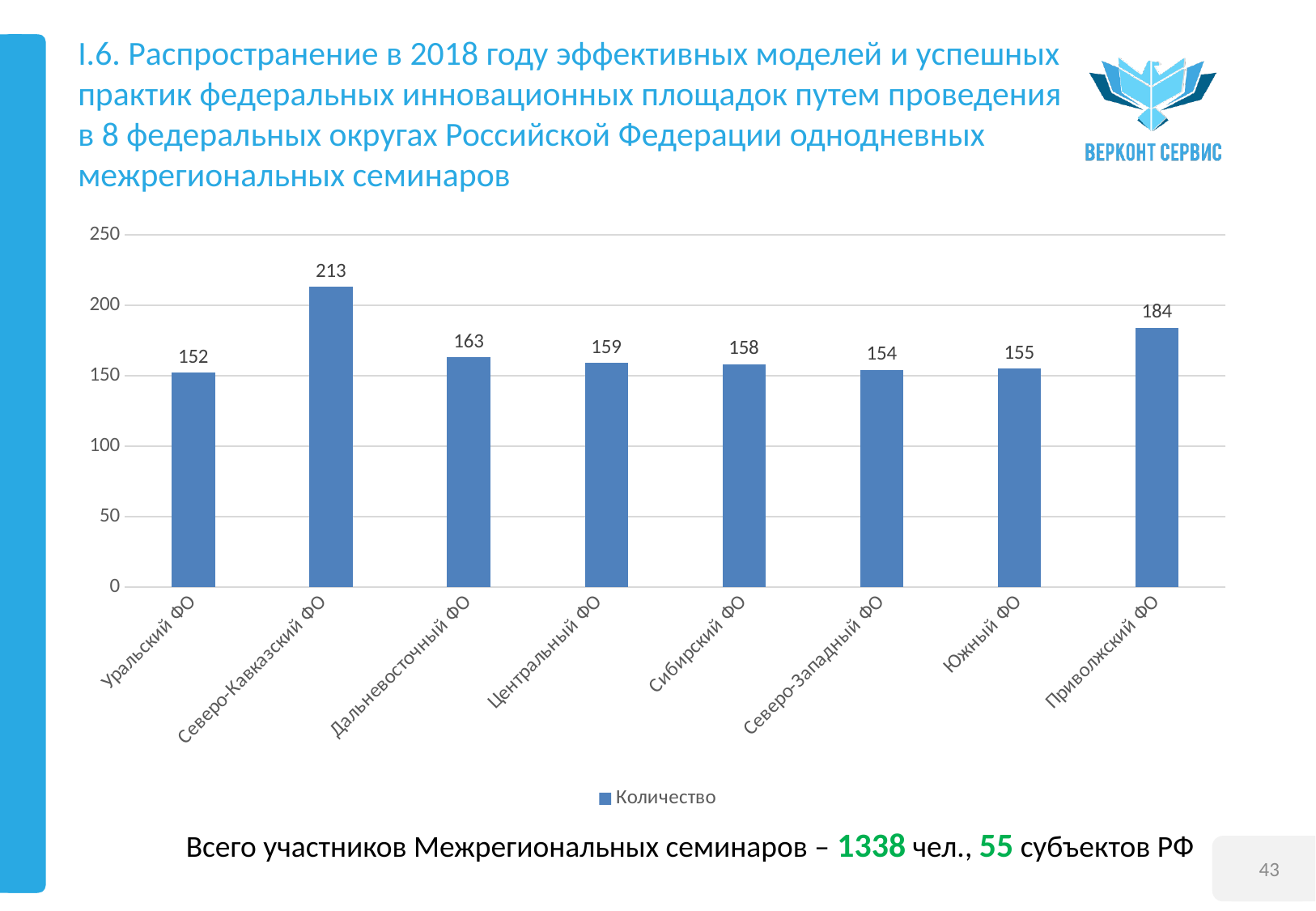
Is the value for Северо-Кавказский ФО greater or less than 200? greater What is the value for Уральский ФО? 152 What is the value for Приволжский ФО? 184 What is the difference between the values for Северо-Кавказский ФО and Приволжский ФО? 29 What is the name of the series in the legend? Количество What is the value for Северо-Кавказский ФО? 213 Which federal district has the highest value? Северо-Кавказский ФО How many federal districts are shown on the chart? 8 Which federal district has the lowest value? Уральский ФО Which is larger, the value for Дальневосточный ФО or the value for Сибирский ФО? Дальневосточный ФО How many series does the legend list? 1 What kind of chart is shown on the slide? bar chart